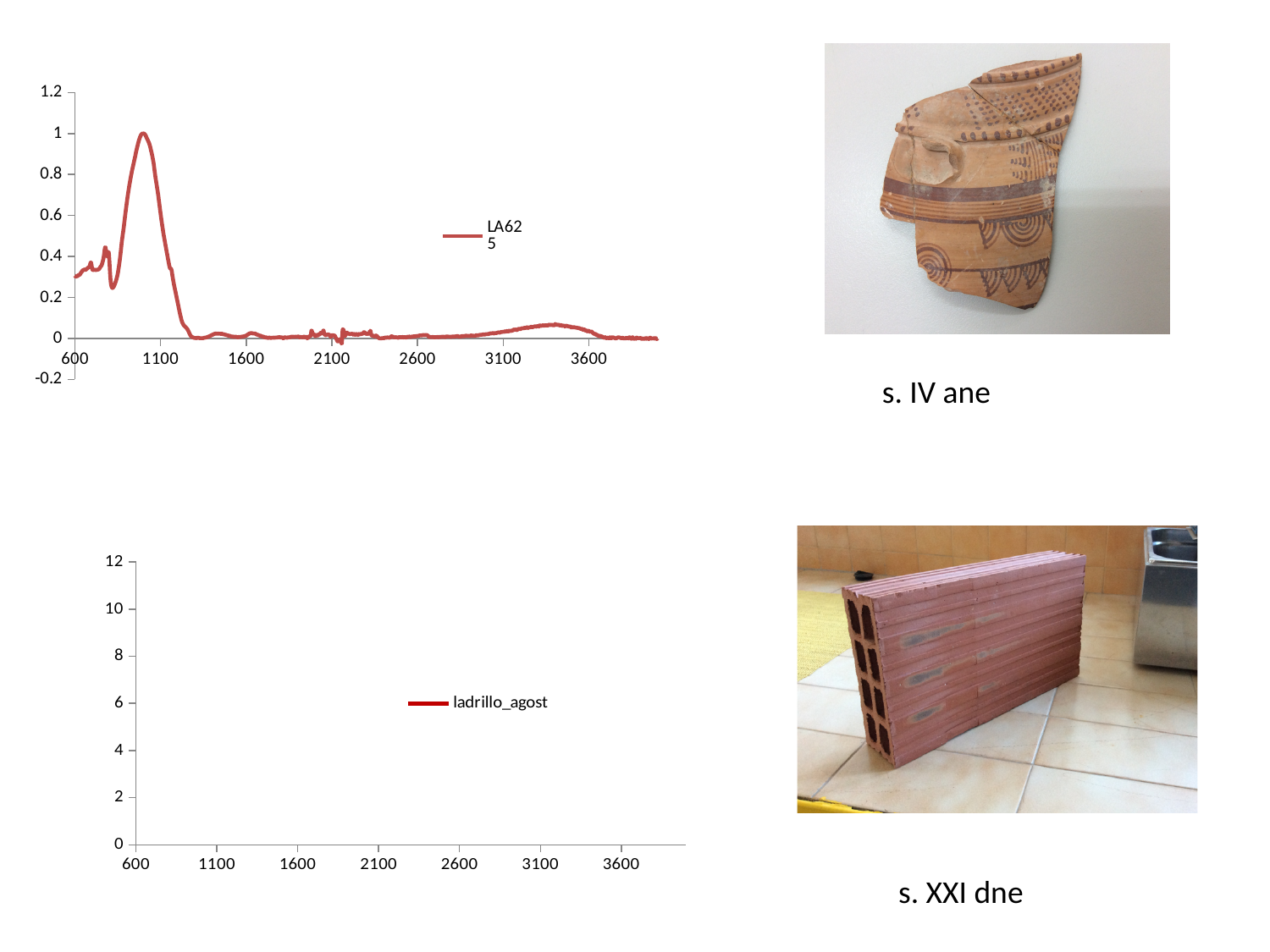
How many series does the legend of the top-left chart list? 1 How many charts are shown on the slide? 2 What is the highest value shown on the y axis of the bottom-left chart? 12 In the top-left chart, is the value at 1000 larger or smaller than the value at 3400? larger What is the legend entry of the bottom-left chart? ladrillo_agost In the top-left chart, is the peak value of the curve greater or less than 0.8? greater What is the highest value shown on the y axis of the top-left chart? 1.2 How many series does the legend of the bottom-left chart list? 1 In the top-left chart, is the value of the curve at 2600 greater or less than 0.2? less What kind of chart is the top-left chart on the slide? line chart In the top-left chart, does the curve rise or fall between 1100 and 1600 on the x axis? fall In the top-left chart, is the value of the curve at 600 greater or less than 0.6? less